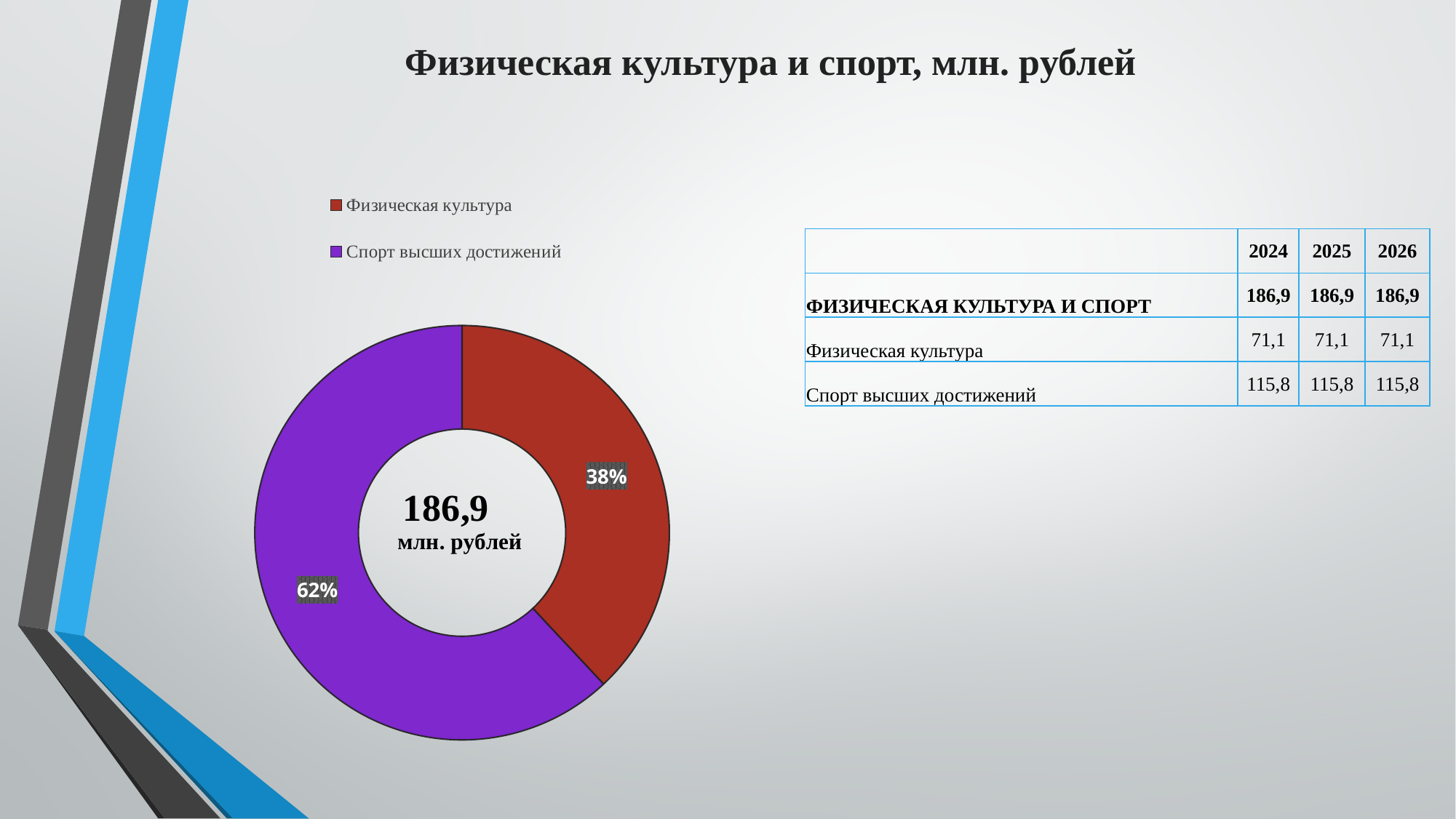
What colour is the Спорт высших достижений slice in the doughnut chart? Purple Which slice is larger: Физическая культура or Спорт высших достижений? Спорт высших достижений How many categories are shown in the doughnut chart? 2 What is the difference in percentage points between the Спорт высших достижений slice and the Физическая культура slice? 24 percentage points What is the title of the slide containing the doughnut chart? Физическая культура и спорт, млн. рублей How many entries does the chart legend list? 2 What share of the doughnut chart does Физическая культура represent? 38% Which category has the largest slice in the doughnut chart? Спорт высших достижений What share of the doughnut chart does Спорт высших достижений represent? 62% What total value is printed in the centre of the doughnut chart? 186,9 млн. рублей Which category has the smallest slice in the doughnut chart? Физическая культура What kind of chart is shown on the slide? Doughnut chart